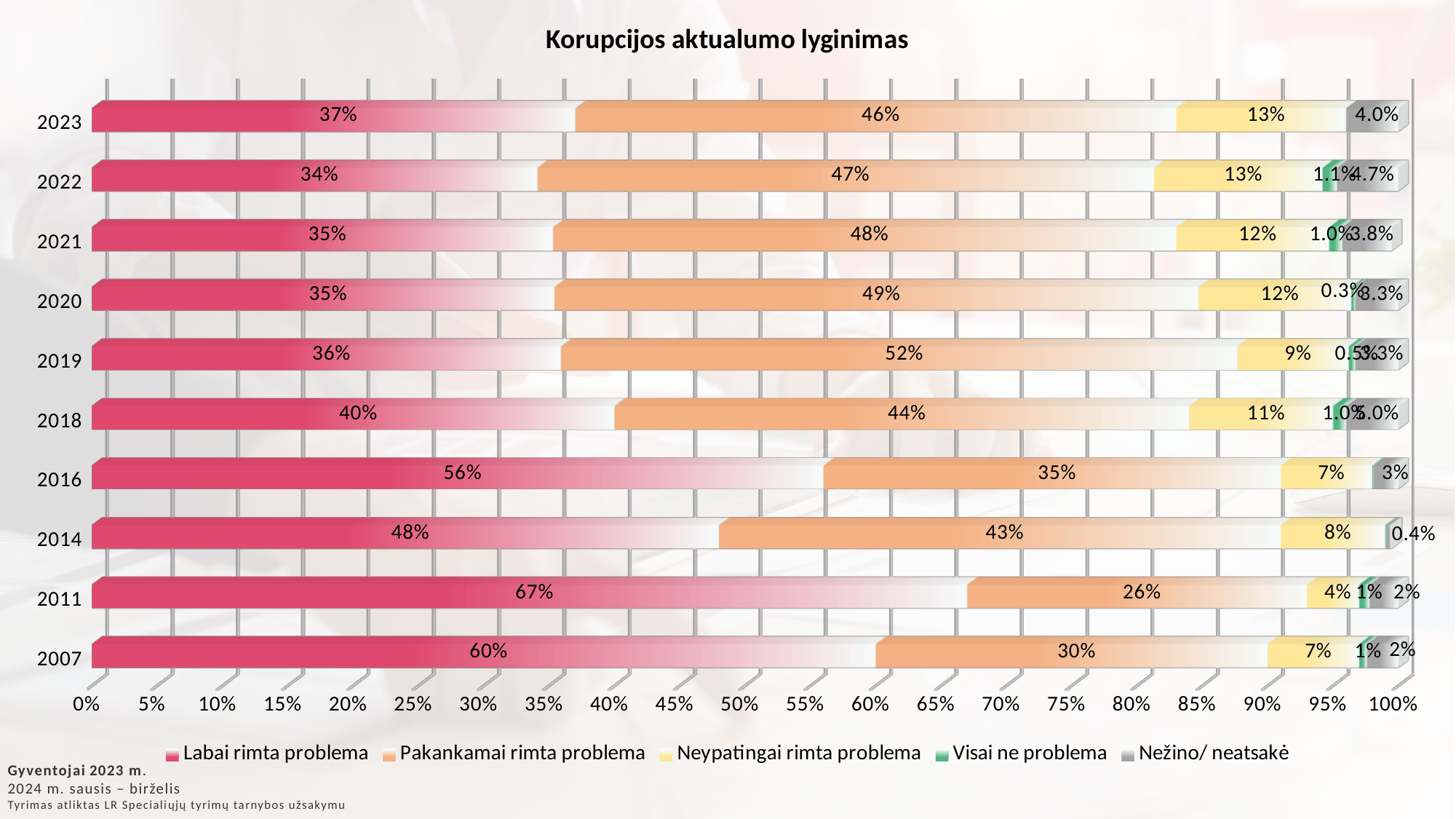
Which year has the lowest value for 'Pakankamai rimta problema'? 2011 What type of chart is shown on the slide? Stacked bar chart What is the value of 'Labai rimta problema' for 2023? 37% Which year has the highest value for 'Labai rimta problema'? 2011 What is the value of 'Pakankamai rimta problema' for 2019? 52% How many years (categories) are shown on the chart? 10 How many series does the legend list? 5 What is the difference between the 'Labai rimta problema' values for 2007 and 2023? 23% What is the title of the chart? Korupcijos aktualumo lyginimas Which is larger: 'Pakankamai rimta problema' for 2014 or for 2016? 2014 What is the value of 'Neypatingai rimta problema' for 2016? 7% What is the value of 'Nežino/ neatsakė' for 2023? 4.0%